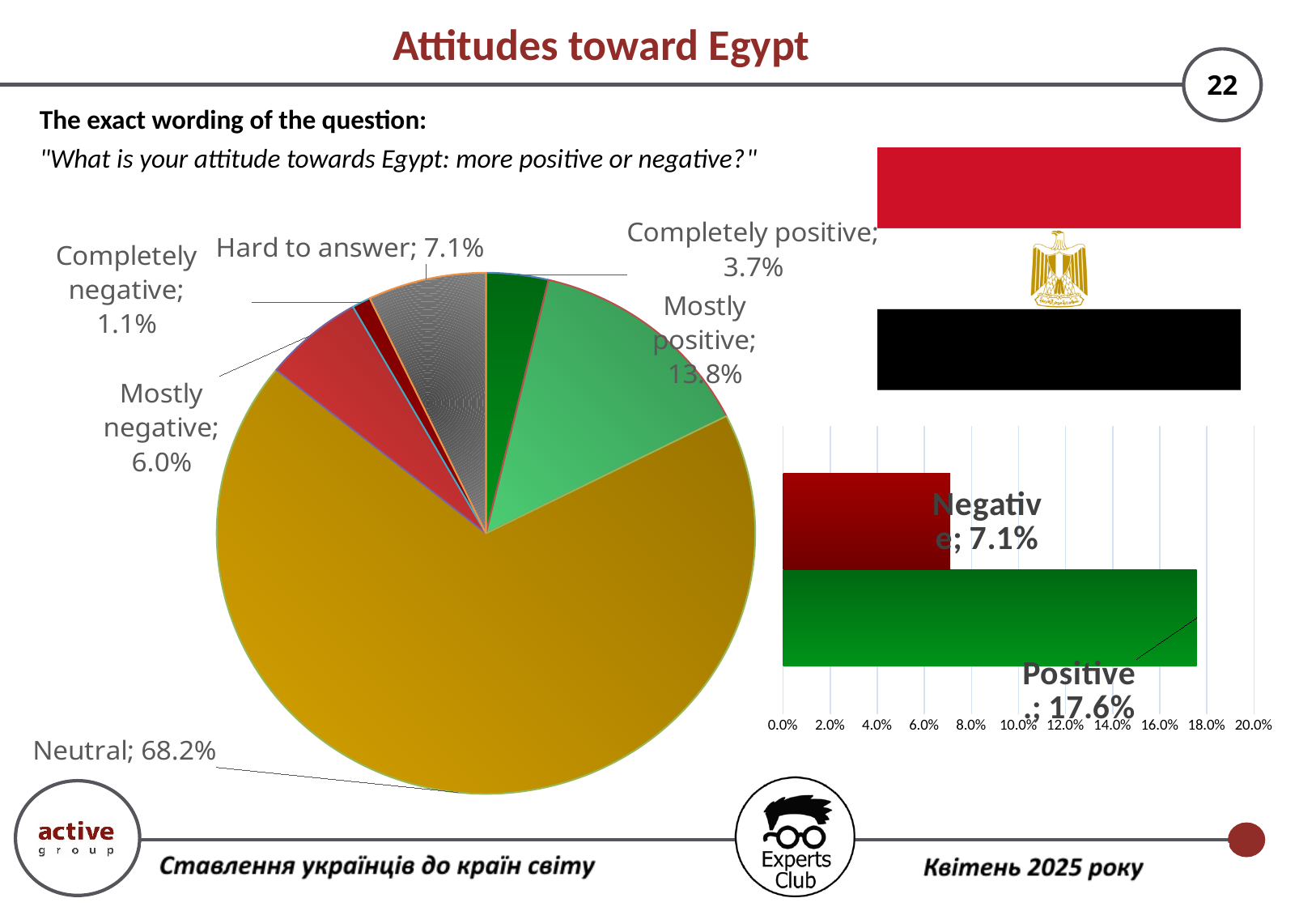
In the pie chart, what share is labelled for Completely negative? 1.1% In the pie chart, which category has the smallest slice? Completely negative In the pie chart, which is larger: Mostly negative or Completely positive? Mostly negative In the pie chart, which category has the largest slice? Neutral In the bar chart on the right, what is the value for Negative? 7.1% What kind of chart is shown on the right side of the slide? Bar chart In the pie chart, what share is labelled for Mostly positive? 13.8% In the pie chart, what share is labelled for Neutral? 68.2% In the pie chart, what is the difference between Mostly positive and Mostly negative? 7.8% In the pie chart, how many slices are there? 6 In the bar chart on the right, what is the value for Positive? 17.6% In the pie chart, what share is labelled for Hard to answer? 7.1%